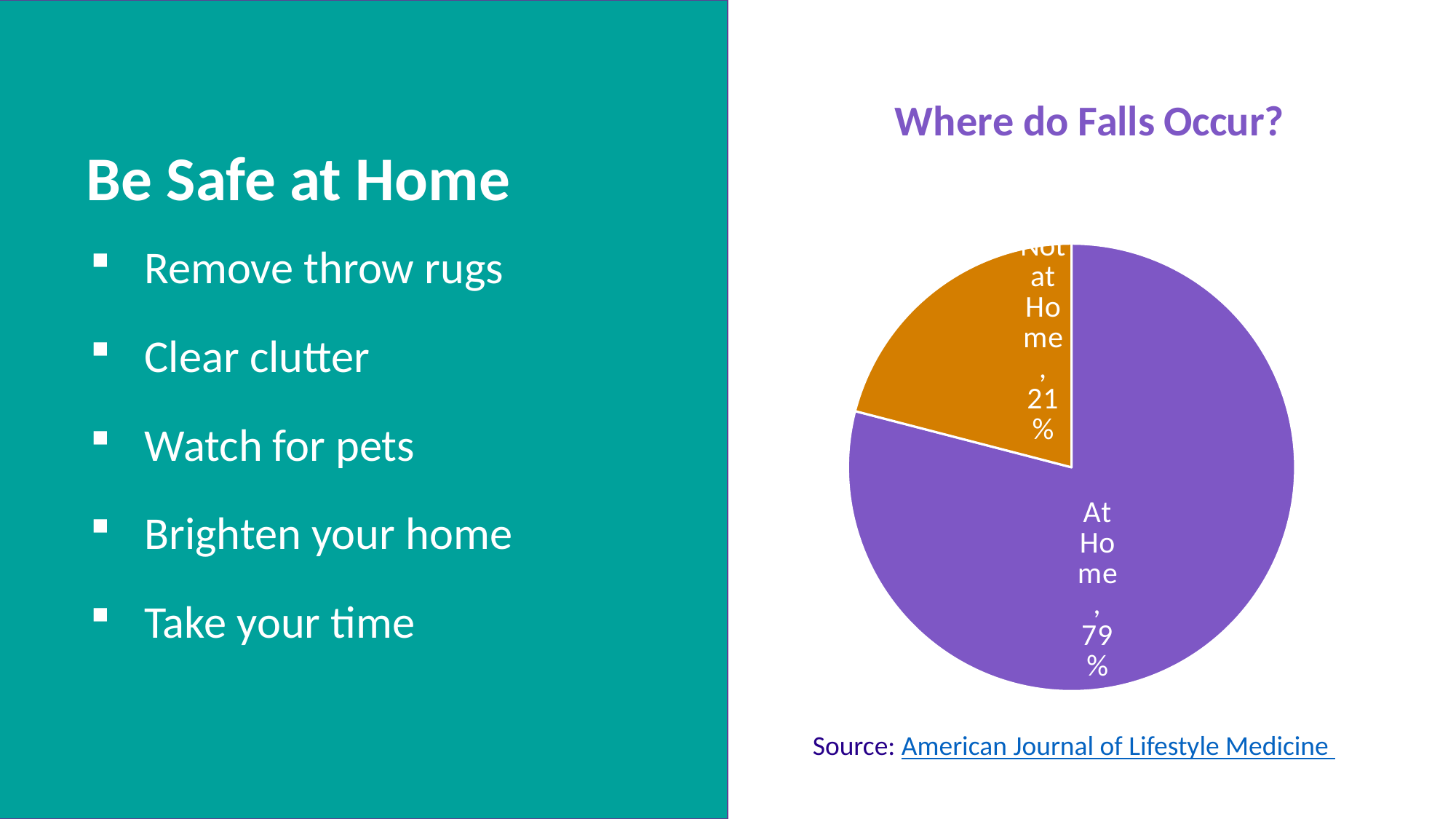
Which slice of the pie is the smallest? Not at Home Which slice of the pie is the largest? At Home What kind of chart is shown under the title "Where do Falls Occur?"? pie chart What is the difference in percentage points between the At Home and Not at Home slices? 58 What percentage of falls occur At Home? 79% How many slices does the pie chart have? 2 What percentage of falls occur Not at Home? 21% Which is larger, the At Home slice or the Not at Home slice? At Home What colour is the At Home slice of the pie chart? purple What is the title of the pie chart? Where do Falls Occur? What share of the pie does the Not at Home slice represent? 21%